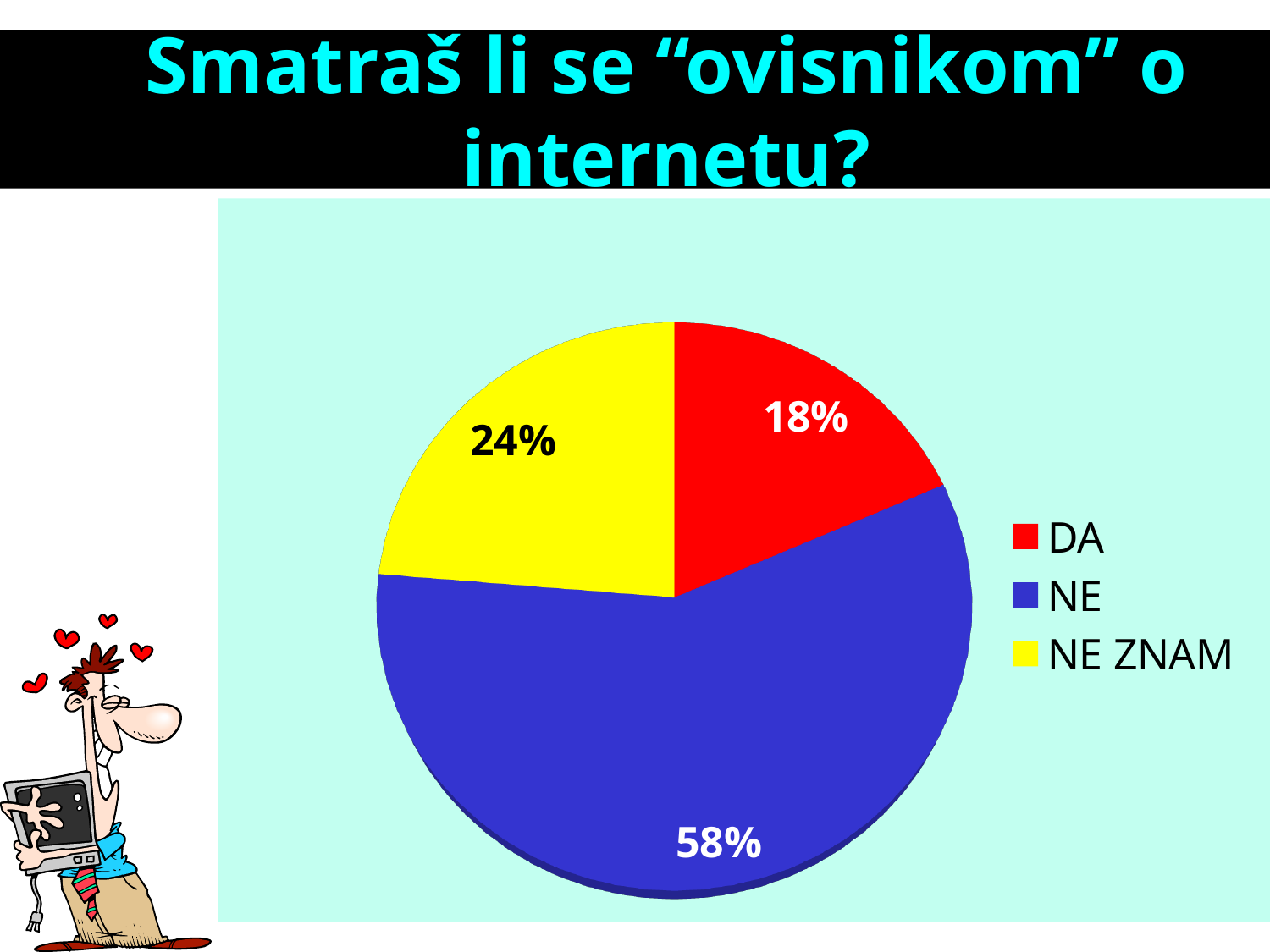
What is the title of the slide containing the chart? Smatraš li se "ovisnikom" o internetu? How many slices does the pie chart have? 3 Which answer has the largest share of the pie? NE What is the difference in percentage points between "NE" and "DA"? 40 What percentage of respondents answered "NE ZNAM"? 24% What kind of chart is shown on the slide? pie chart What percentage of respondents answered "NE"? 58% What colour is the slice for "NE"? blue Which answer has the smallest share of the pie? DA What is the difference in percentage points between "NE ZNAM" and "DA"? 6 What percentage of respondents answered "DA"? 18% Which is larger, the share for "NE ZNAM" or the share for "DA"? NE ZNAM